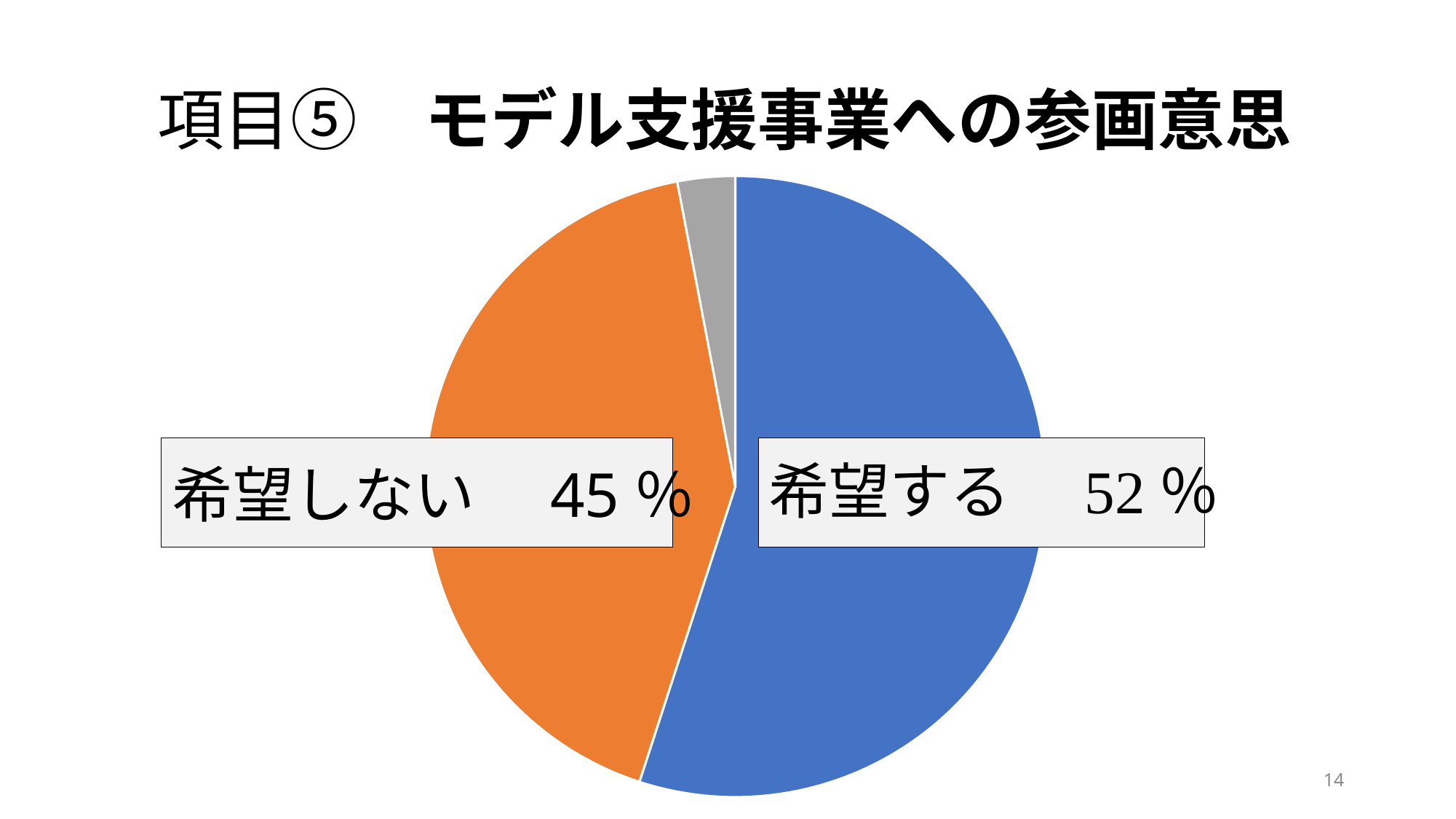
Which is larger, the share for 希望する or the share for 希望しない? 希望する What is the title of the slide containing the pie chart? 項目⑤ モデル支援事業への参画意思 What kind of chart is shown on the slide? Pie chart Is the share for 希望する greater or less than 50%? greater What percentage of the pie is labelled 希望する? 52% What percentage of the pie is labelled 希望しない? 45% What is the difference between the share for 希望する and the share for 希望しない? 7 percentage points How many slices does the pie chart have? 3 What colour is the slice for 希望する? Blue Which labelled category has the largest share of the pie? 希望する